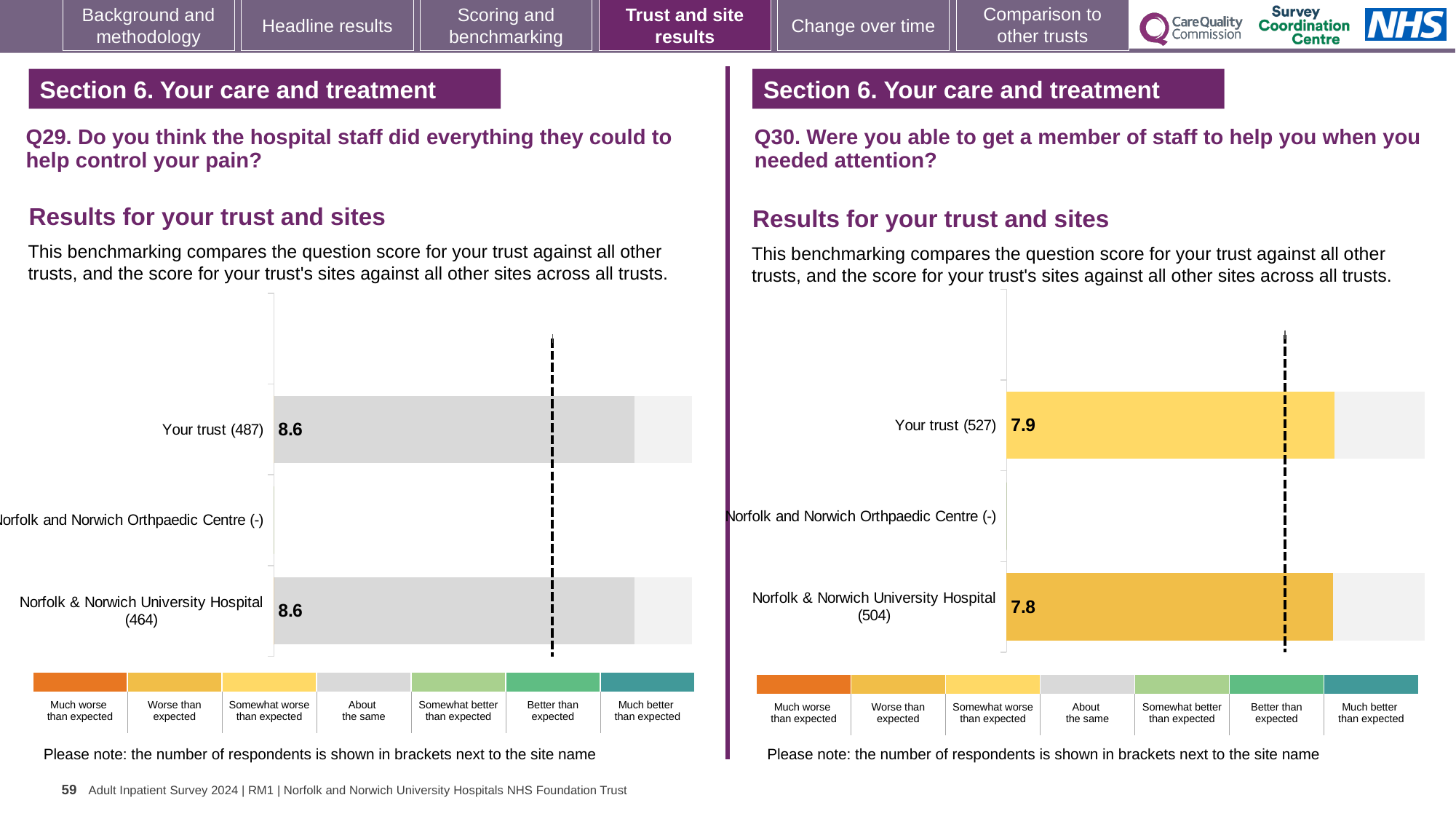
On the Q30 chart (right), what is the score for Norfolk & Norwich University Hospital? 7.8 On the Q29 chart (left), what is the score for Norfolk & Norwich University Hospital? 8.6 On the Q29 chart (left), what is the score for Your trust? 8.6 On the Q29 chart (left), what is the difference between the score for Your trust and the score for Norfolk & Norwich University Hospital? 0 On the Q29 chart (left), how many categories are listed on the vertical axis? 3 What kind of chart is the Q30 chart (right)? Bar chart On the Q30 chart (right), what is the difference between the score for Your trust and the score for Norfolk & Norwich University Hospital? 0.1 On the Q30 chart (right), which has the higher score, Your trust or Norfolk & Norwich University Hospital? Your trust On the Q29 chart (left), how many respondents are shown in brackets for Your trust? 487 On the Q30 chart (right), how many respondents are shown in brackets for Norfolk & Norwich University Hospital? 504 On the Q30 chart (right), what is the score for Your trust? 7.9